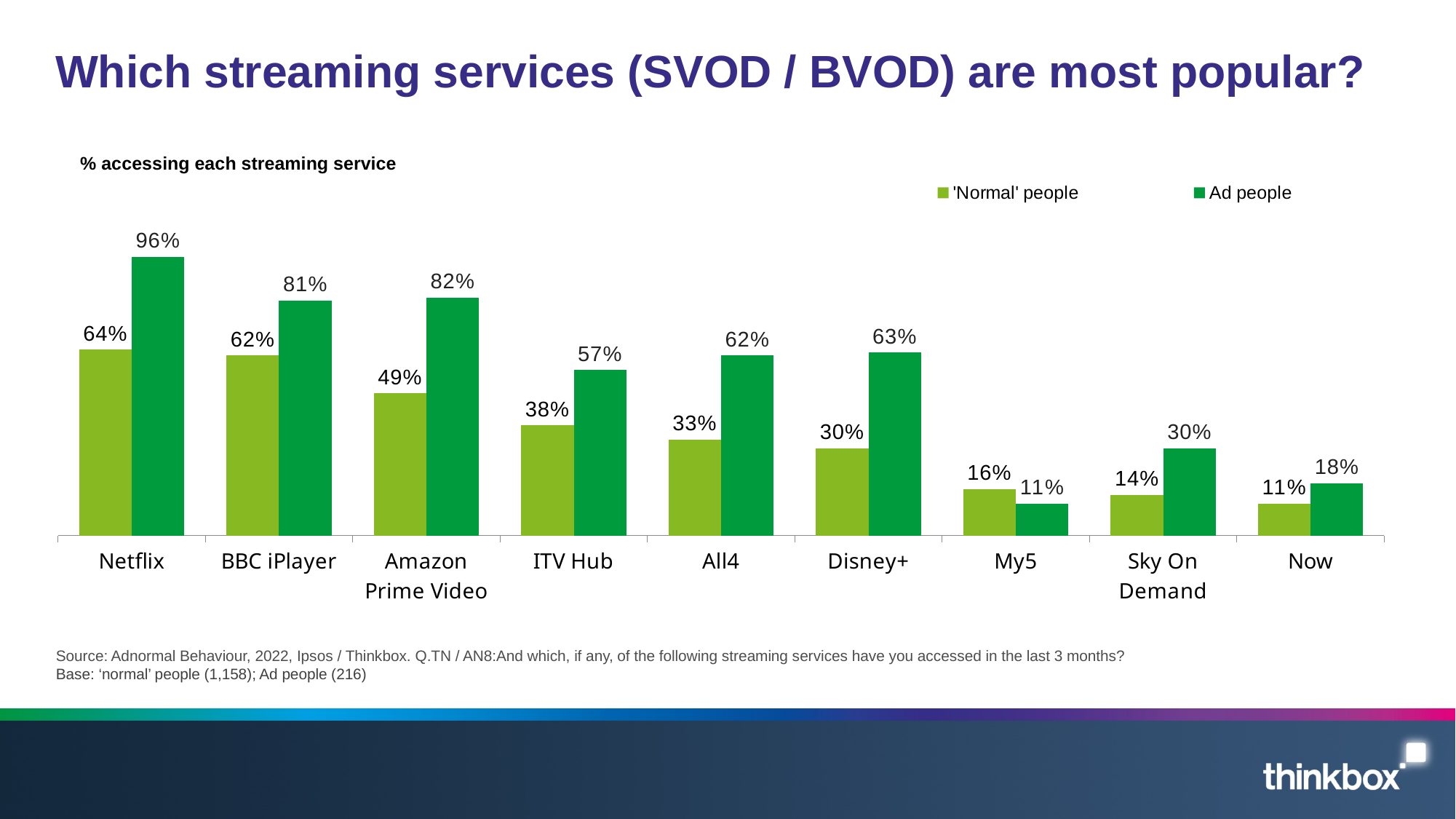
How many streaming services are shown on the x axis? 9 Which streaming service has the lowest value for 'Normal' people? Now For My5, which group has the larger value, 'Normal' people or Ad people? 'Normal' people What is the difference between Ad people and 'Normal' people for Netflix? 32% What is the difference between Ad people and 'Normal' people for Disney+? 33% What kind of chart is shown on the slide? Bar chart Which streaming service has the highest value for Ad people? Netflix What is the value for Ad people for Sky On Demand? 30% What percentage of Ad people access Amazon Prime Video? 82% What is the subtitle printed above the chart? % accessing each streaming service What percentage of 'Normal' people access Netflix? 64% How many series does the legend list? 2